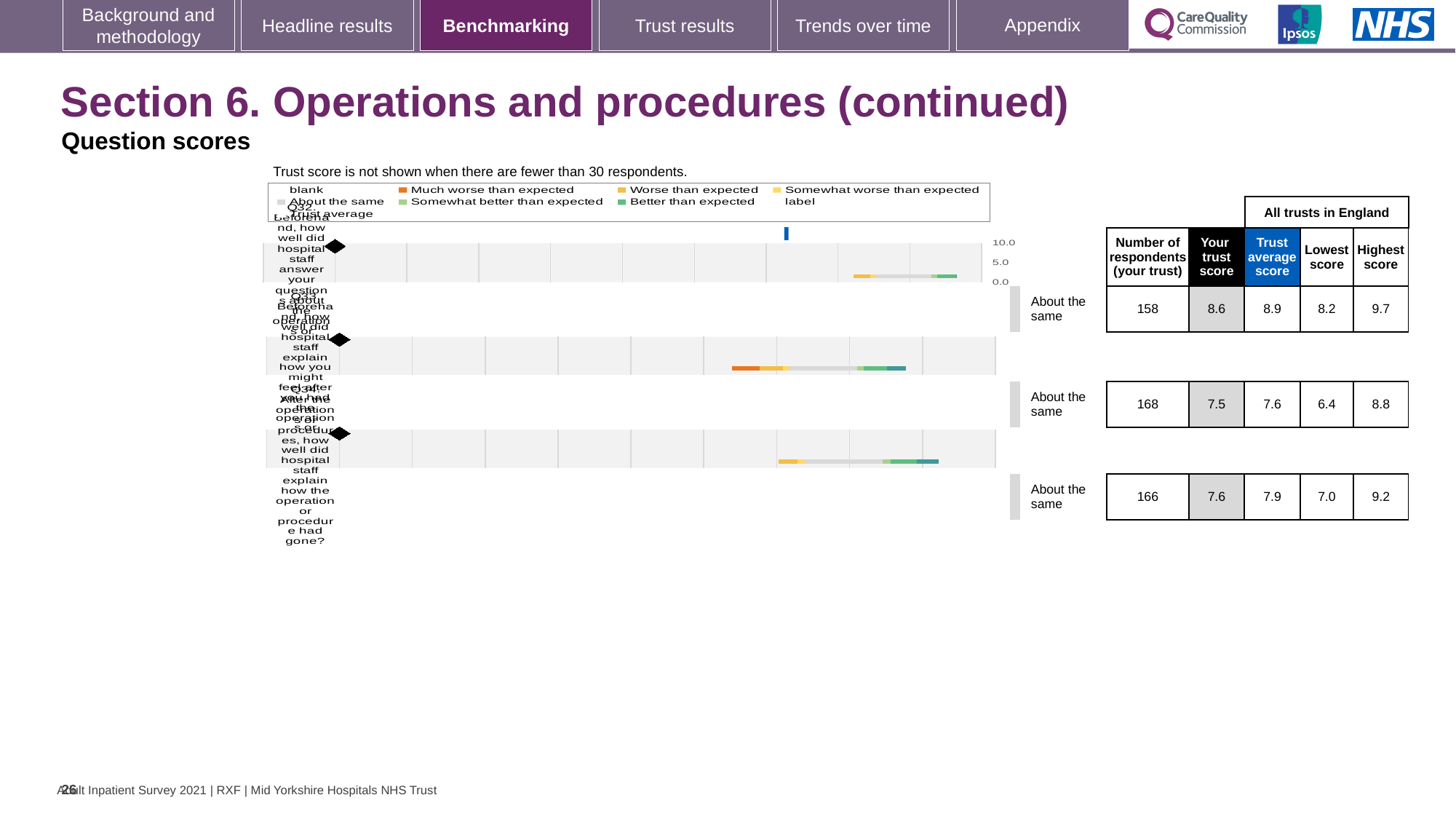
In the benchmarking table, how many respondents (your trust) are shown for the first question row? 158 In the benchmarking table, is 'Your trust score' larger for the first question row or the third question row? The first row In the benchmarking table, what is the difference between the 'Highest score' and 'Lowest score' for the second question row? 2.4 What kind of chart is used for the benchmarking results on this slide? Bar chart What benchmark category label is shown next to each of the three question rows? About the same Which question row has the highest 'Your trust score' in the benchmarking table? The first row (8.6) In the benchmarking table, what is the 'Highest score' for the first question row? 9.7 In the benchmarking table, what is the difference between the 'Trust average score' and 'Your trust score' for the first question row? 0.3 In the benchmarking table, what is the 'Trust average score' for the third question row? 7.9 In the benchmarking table, what is the 'Lowest score' for the second question row? 6.4 In the benchmarking table, what is 'Your trust score' for the second question row? 7.5 How many question rows are plotted in the benchmarking chart on this slide? 3